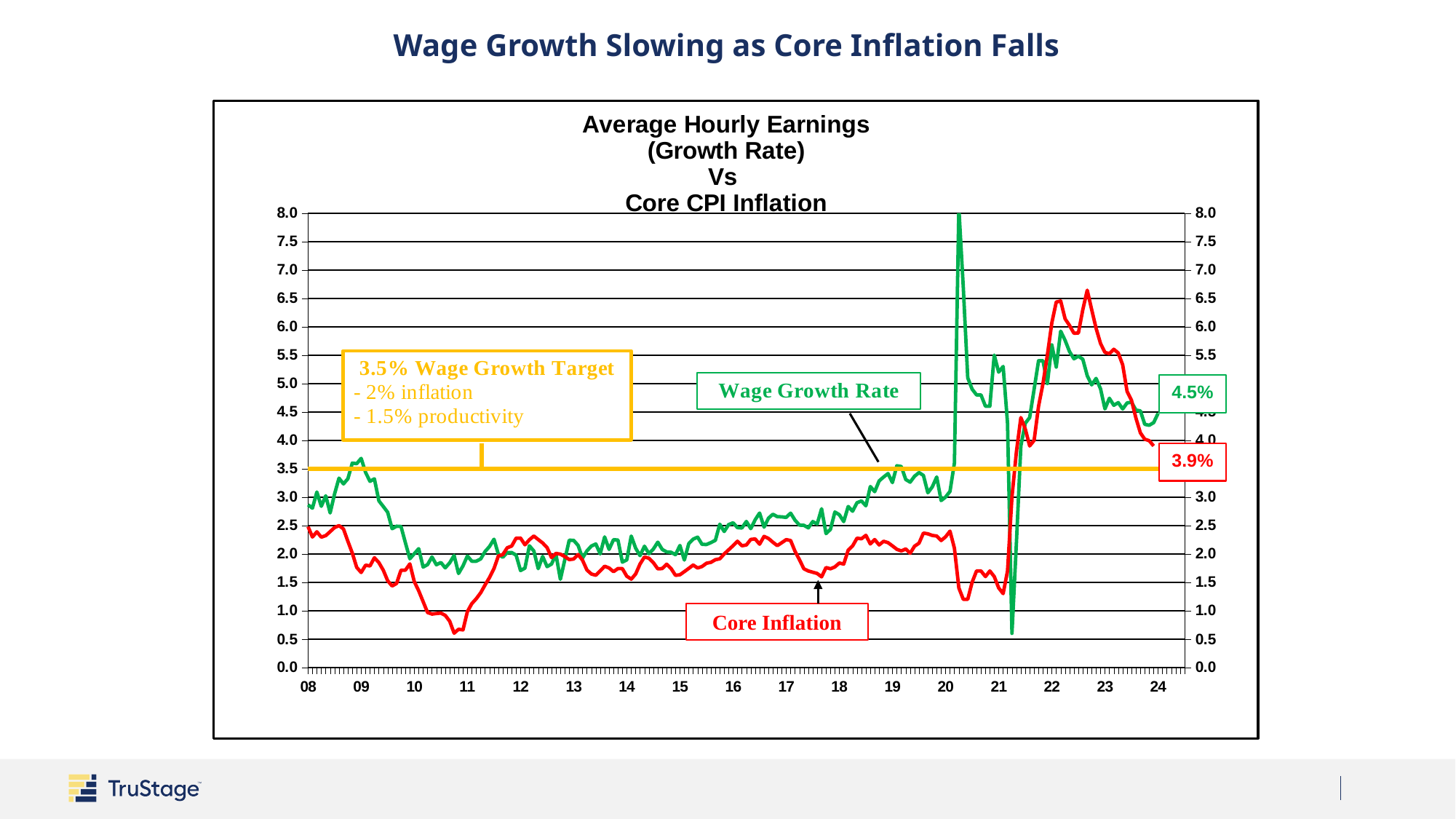
What colour is the Core Inflation line? red What is the latest labelled value of the Core Inflation line? 3.9% How many data series are plotted in the chart? 3 What kind of chart is shown on the slide? line chart What is the latest labelled value of the Wage Growth Rate line? 4.5% At the end of the chart, which is higher: the Wage Growth Rate or Core Inflation? Wage Growth Rate What value is the horizontal yellow Wage Growth Target line set at? 3.5% Is the peak of the Wage Growth Rate line in 2020 greater or less than 7.0? greater Is the lowest point of the Core Inflation line around 2010-2011 greater or less than 1.0? less What is the difference between the latest labelled Wage Growth Rate (4.5%) and the latest labelled Core Inflation (3.9%)? 0.6% Is the peak of the Core Inflation line in 2022 greater or less than 6.0? greater From its 2022 peak to the end of the chart, does the Core Inflation line rise or fall? fall